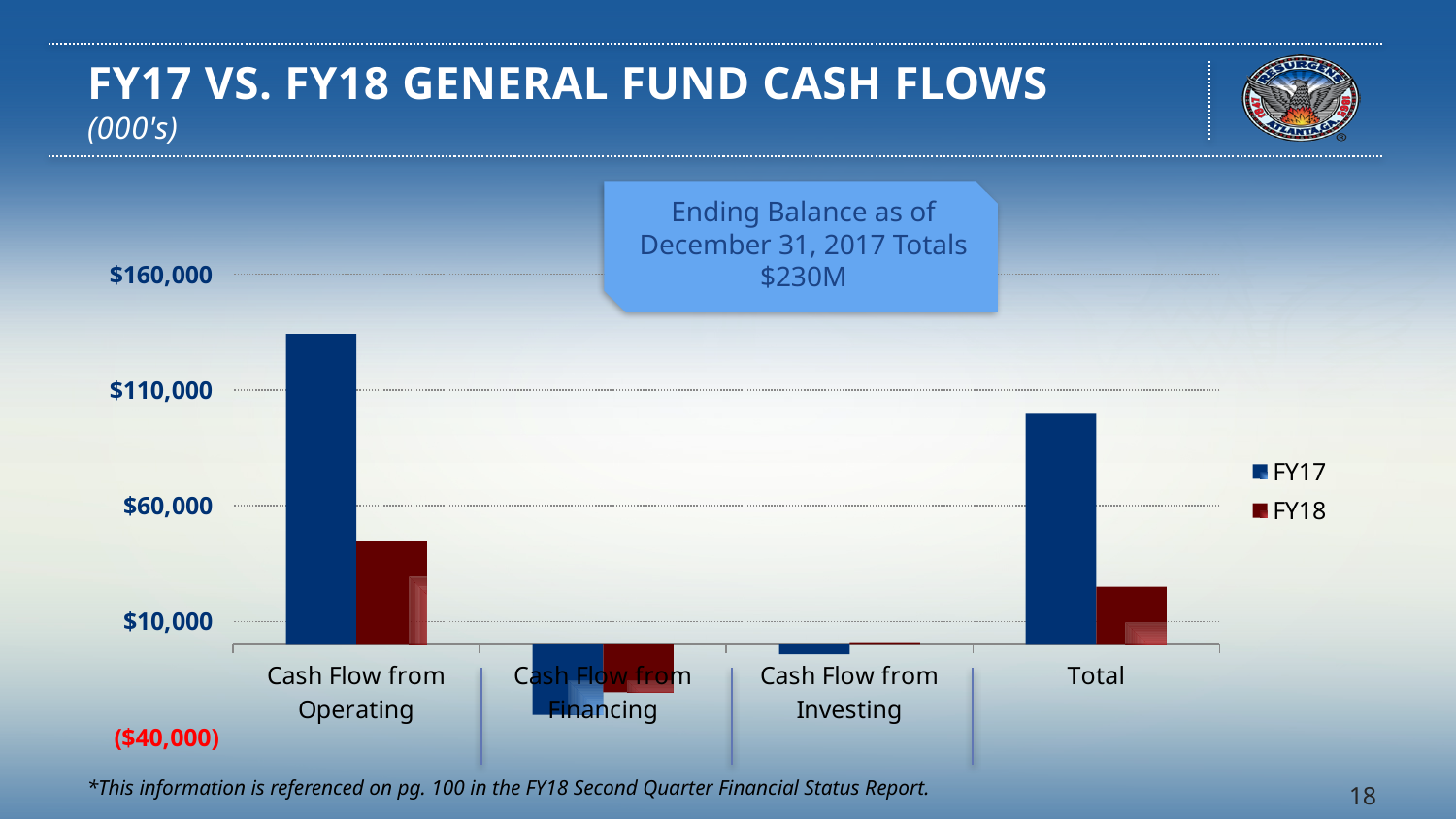
Which category has the lowest FY17 value? Cash Flow from Financing Is the FY18 value for Total greater or less than $10,000? greater For Cash Flow from Operating, which series has the larger value, FY17 or FY18? FY17 Is the FY18 value for Cash Flow from Operating greater or less than $60,000? less How many series does the chart's legend list? 2 According to the callout on the chart, what is the ending balance total as of December 31, 2017? $230M Is the FY17 value for Total greater or less than $110,000? less Which category has the highest FY17 value? Cash Flow from Operating How many categories are shown on the x axis of the chart? 4 What kind of chart is shown on the slide? bar chart Which series is shown in blue in the chart's legend? FY17